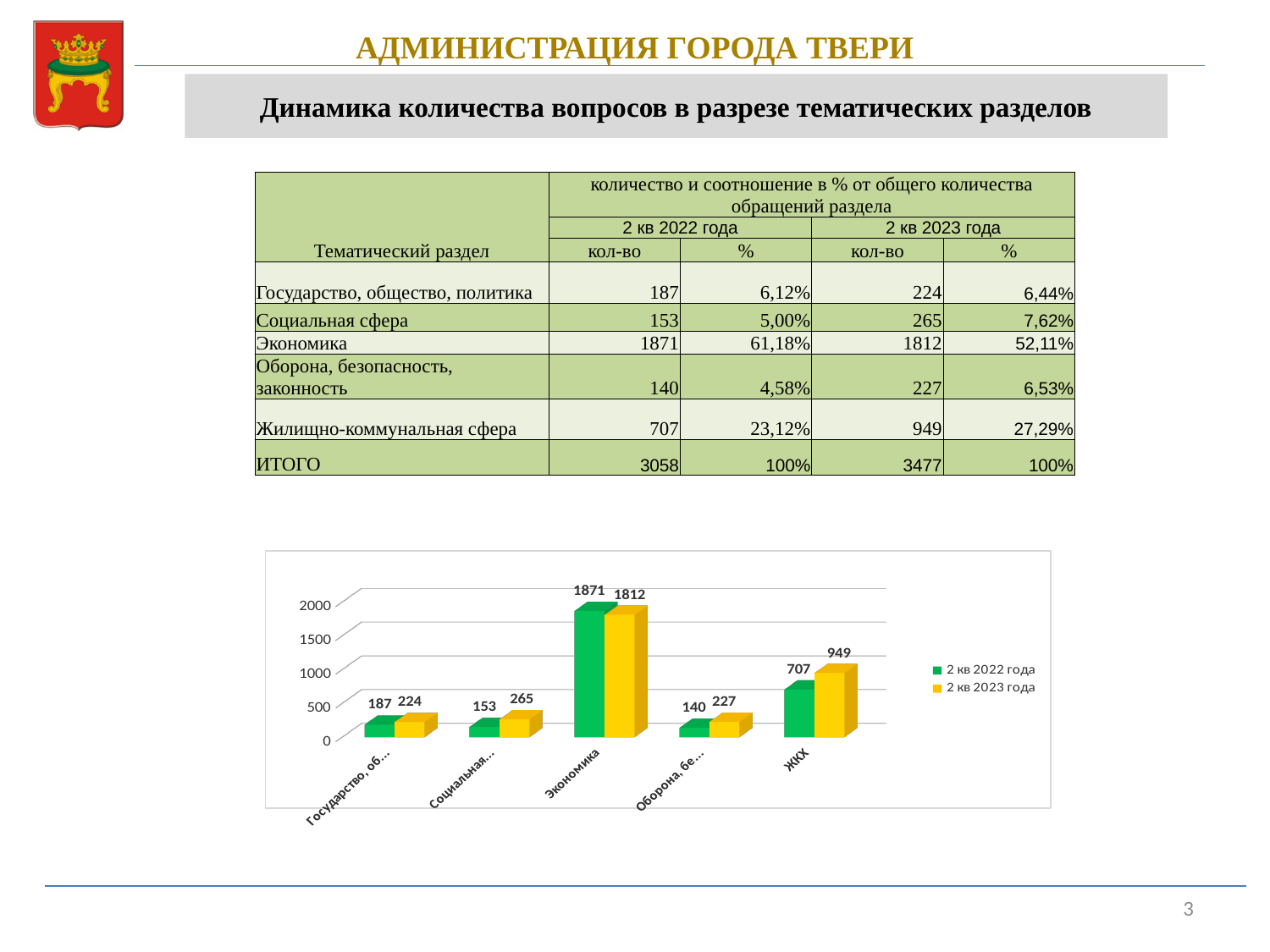
What is the value for Экономика in the series 2 кв 2022 года? 1871 Which legend entry is shown in yellow? 2 кв 2023 года How many categories are plotted on the chart? 5 Which category has the highest value in the series 2 кв 2022 года? Экономика What is the value for Экономика in the series 2 кв 2023 года? 1812 Which category has the lowest value in the series 2 кв 2022 года? Оборона, безопасность, законность For Экономика, which series has the larger value: 2 кв 2022 года or 2 кв 2023 года? 2 кв 2022 года What kind of chart is shown on the slide? bar chart How many series does the chart legend list? 2 What is the difference between the 2 кв 2023 года and 2 кв 2022 года values for ЖКХ? 242 What is the value for ЖКХ in the series 2 кв 2023 года? 949 Is the value for ЖКХ in the series 2 кв 2022 года greater or less than 500? greater